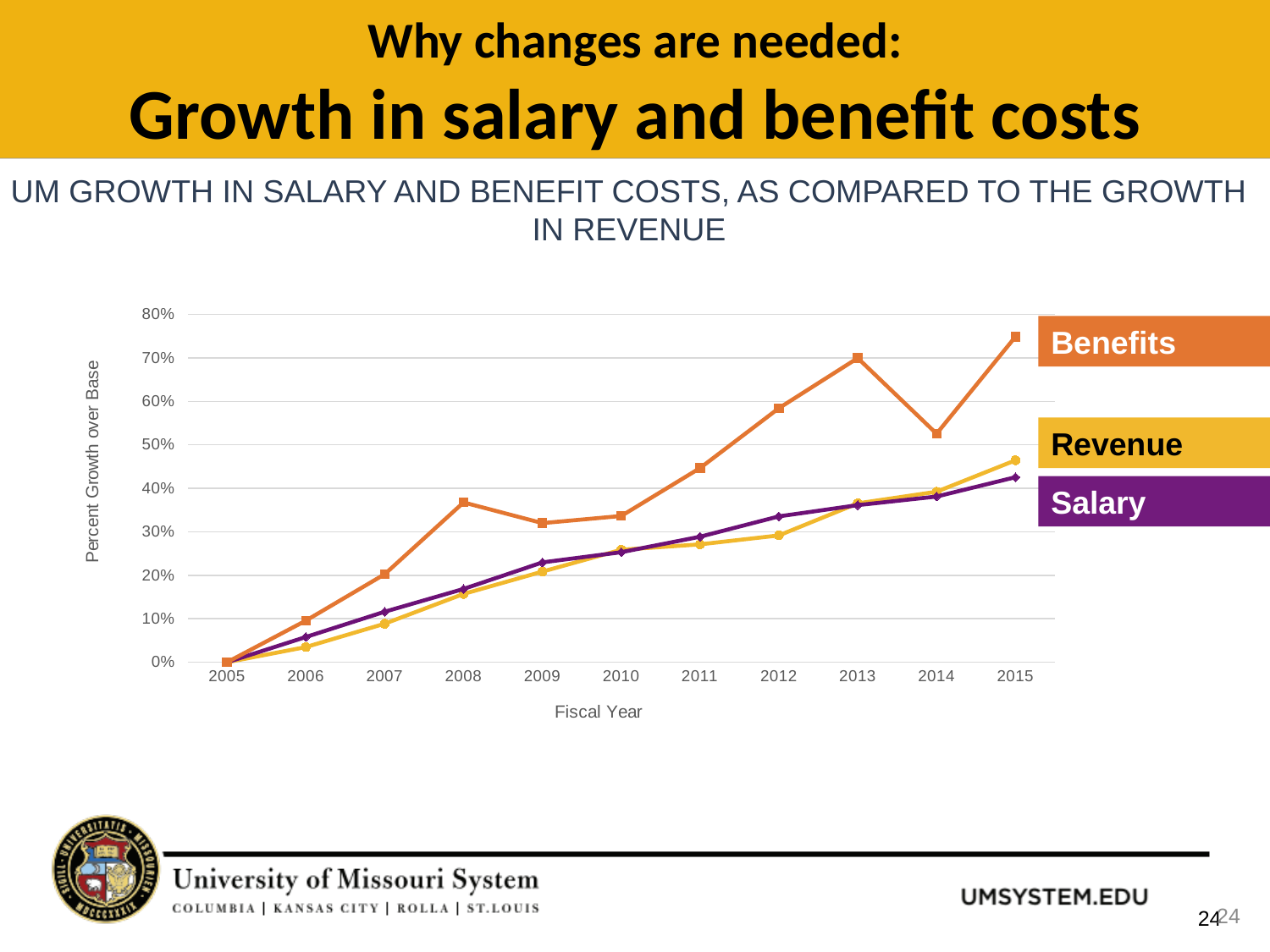
What is the label on the y axis? Percent Growth over Base Is the value for Benefits in 2014 greater or less than 60%? less Is the value for Salary in 2015 greater or less than 50%? less Which series has the highest value in 2015? Benefits Which is larger in 2012, Benefits or Salary? Benefits How many fiscal years are plotted along the x axis? 11 Is the value for Benefits in 2013 greater or less than 60%? greater What is the value for all three series in 2005? 0% How many series does the chart's legend list? 3 Which series has the lowest value in 2006? Revenue What kind of chart is shown on the slide? line chart